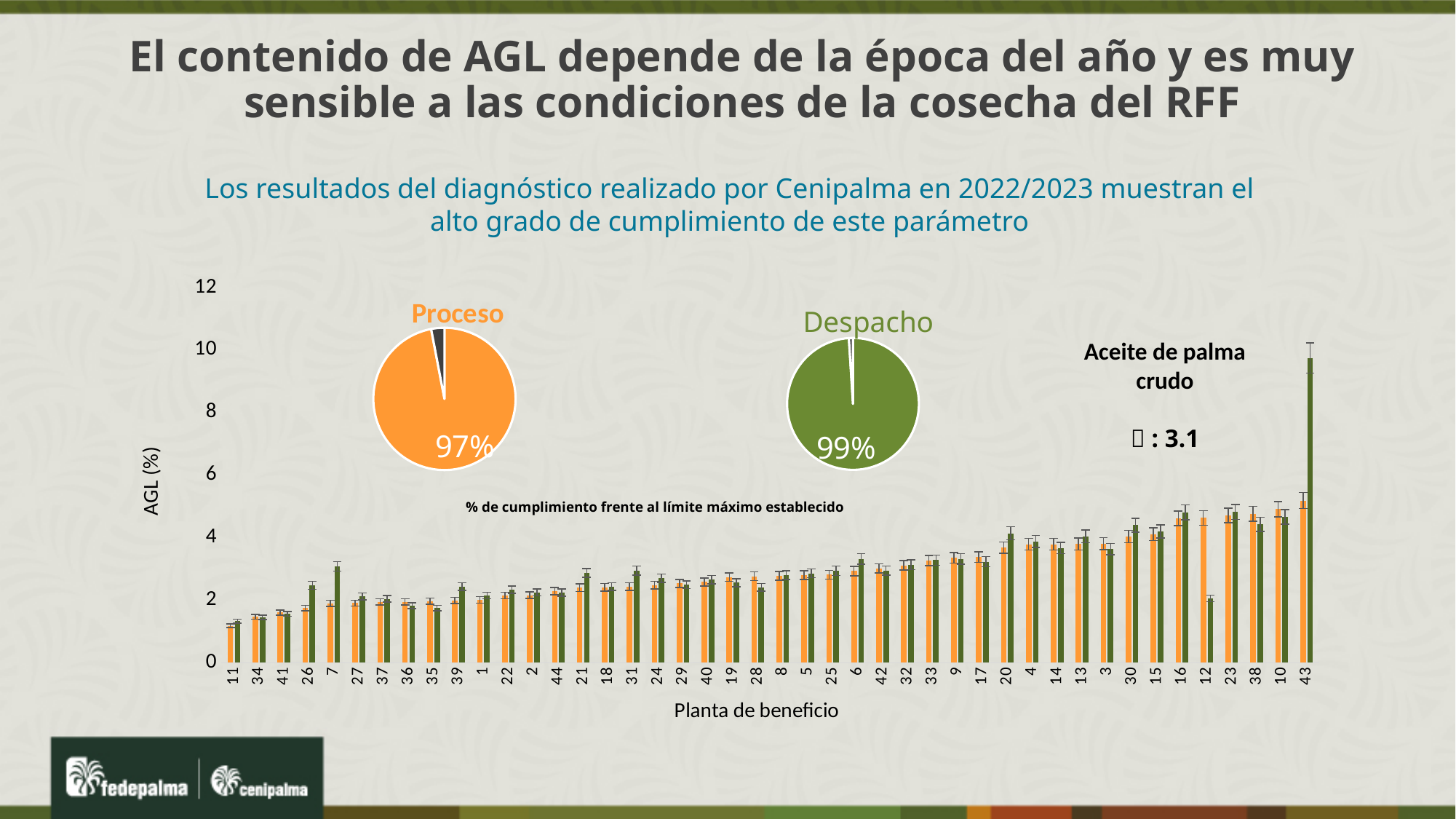
Which of the two pie charts, Proceso or Despacho, shows the higher compliance percentage? Despacho In the bar chart of AGL (%) by Planta de beneficio, which plant has the highest bar? 43 In the bar chart of AGL (%) by Planta de beneficio, are the bars for plant 11 greater or less than 2? less In the Despacho pie chart, what percentage of compliance is shown? 99% What kind of chart is the large chart at the bottom of the slide showing AGL (%) by Planta de beneficio? bar chart In the bar chart of AGL (%) by Planta de beneficio, is the green bar for plant 16 greater or less than 4? greater In the Proceso pie chart, what percentage of compliance is shown? 97% In the bar chart of AGL (%) by Planta de beneficio, how many plants (categories) are shown on the x axis? 44 In the bar chart of AGL (%) by Planta de beneficio, which plant has a larger value, plant 43 or plant 11? 43 In the bar chart of AGL (%) by Planta de beneficio, is the tallest bar for plant 43 greater or less than 8? greater In the bar chart of AGL (%) by Planta de beneficio, do the values generally rise or fall from left to right along the x axis? rise What is the label of the y axis of the bar chart? AGL (%)